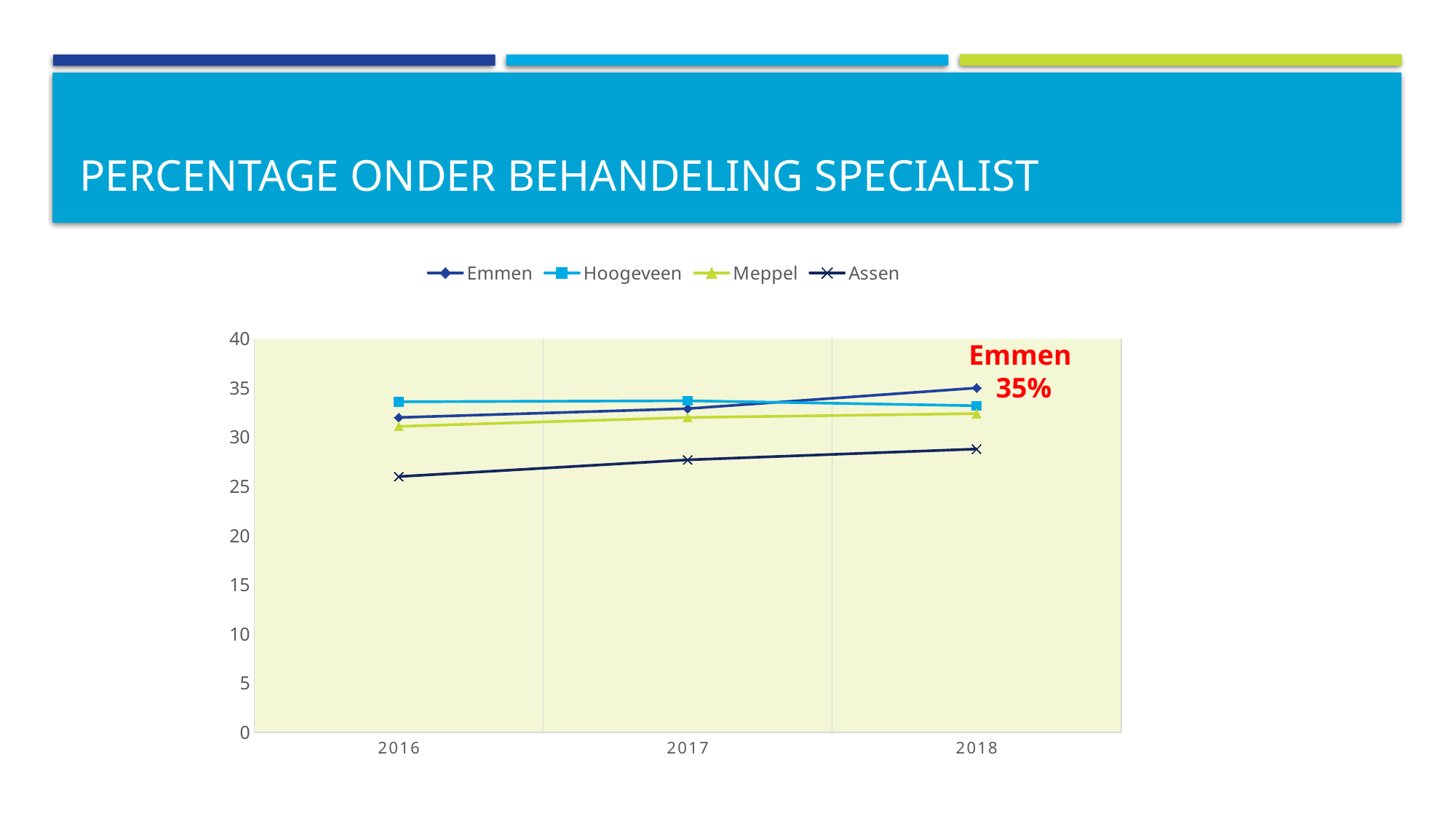
Is the value for Hoogeveen in 2016 greater or less than 30? greater Which series has the highest value in 2018? Emmen How many years are shown on the x axis? 3 What is the title of the slide? PERCENTAGE ONDER BEHANDELING SPECIALIST Does the value for Assen rise or fall from 2016 to 2018? rise What kind of chart is shown on the slide? line chart Which is larger in 2018, the value for Meppel or the value for Assen? Meppel What is the value for Emmen in 2018? 35% Which series has the lowest value in 2016? Assen Does the value for Emmen rise or fall from 2016 to 2018? rise Is the value for Assen in 2016 greater or less than 30? less How many series does the legend list? 4